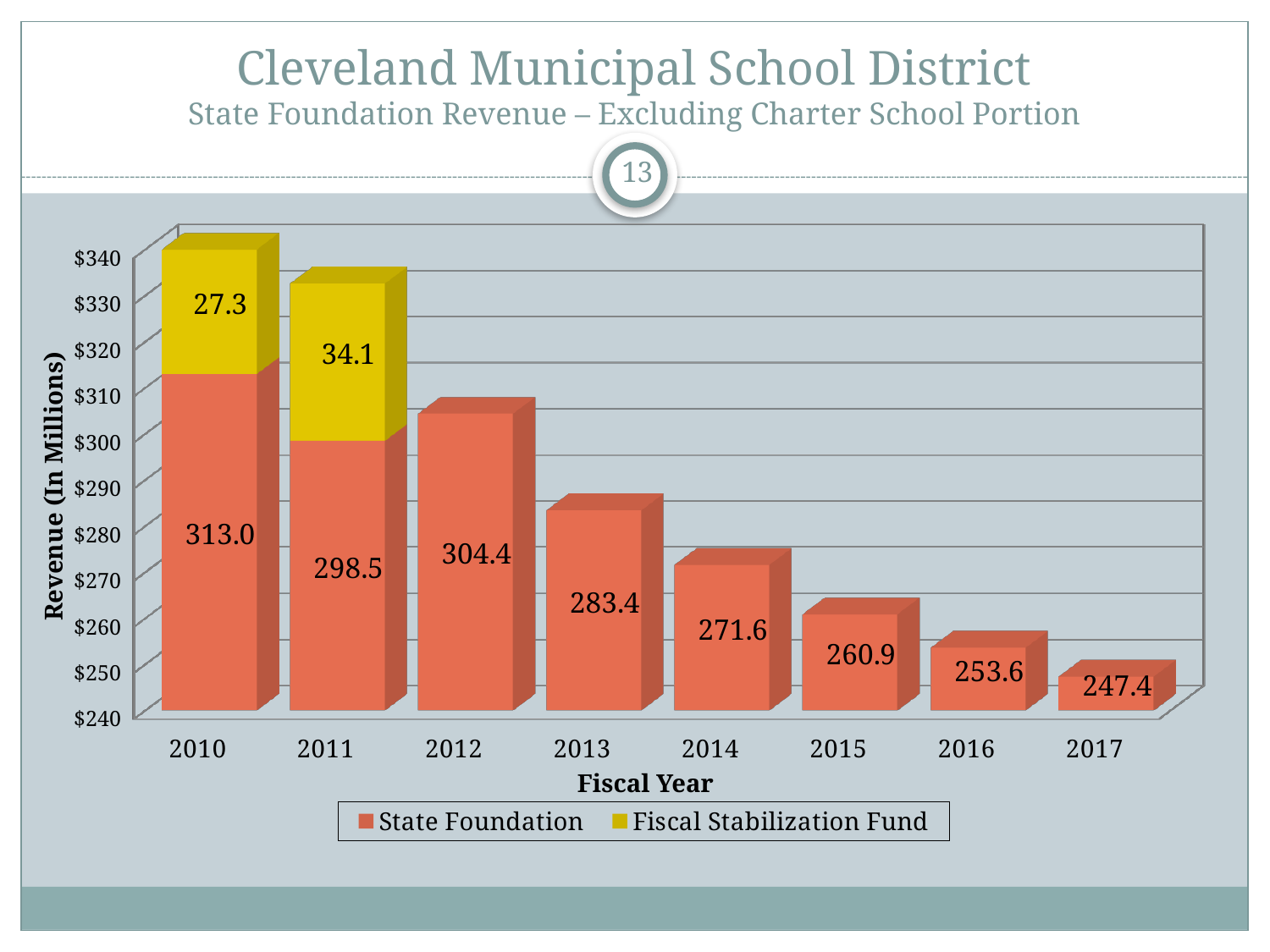
What is the Fiscal Stabilization Fund value for fiscal year 2011? 34.1 What is the State Foundation value for fiscal year 2012? 304.4 Which is larger, the State Foundation value for 2011 or for 2012? 2012 How many fiscal years are shown on the x axis? 8 Which fiscal year has the highest State Foundation value? 2010 What is the difference between the State Foundation values for 2013 and 2014? 11.8 What is the total of the stacked bar for fiscal year 2010? 340.3 What is the State Foundation value for fiscal year 2017? 247.4 Which fiscal year has the lowest State Foundation value? 2017 What kind of chart is shown on the slide? Stacked bar chart Do the State Foundation values rise or fall from 2012 to 2017? Fall How many series does the legend list? 2